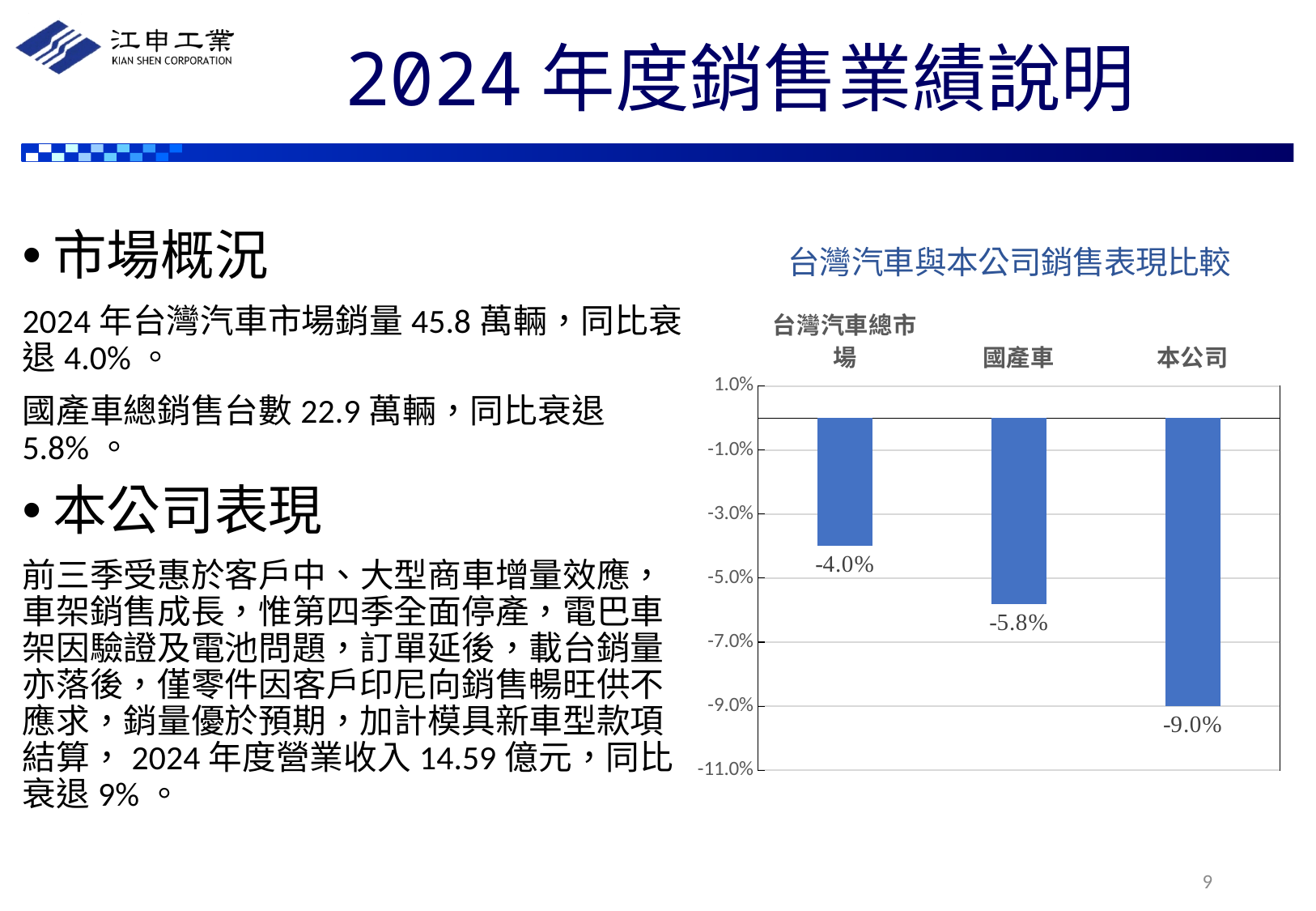
What kind of chart is shown on the slide? Bar chart What is the difference between the values for 國產車 and 台灣汽車總市場? 1.8 percentage points What is the value for 國產車 in the chart? -5.8% Which is larger, the value for 國產車 or the value for 本公司? 國產車 Is the value for 本公司 greater or less than -7.0%? less Which category has the lowest value in the chart? 本公司 What is the value for 台灣汽車總市場 in the chart? -4.0% What is the value for 本公司 in the chart? -9.0% How many categories are shown in the chart? 3 Which category has the highest value in the chart? 台灣汽車總市場 What is the title of the chart? 台灣汽車與本公司銷售表現比較 What is the difference between the values for 本公司 and 台灣汽車總市場? 5.0 percentage points